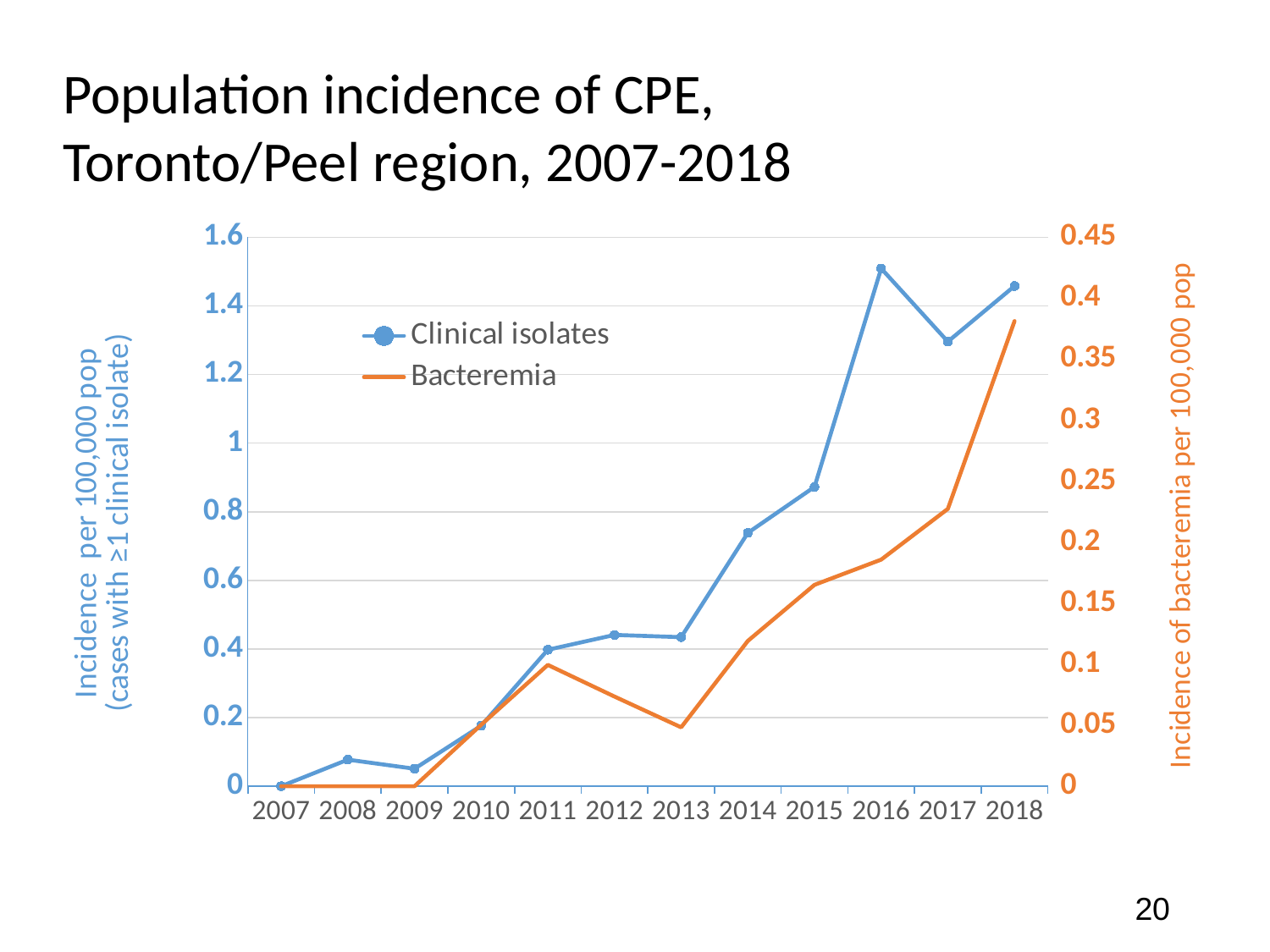
Is the Clinical isolates value for 2016 greater or less than 1.4? greater In which year is the Clinical isolates incidence highest? 2016 Is the Bacteremia value for 2018 greater or less than 0.35? greater What is the Clinical isolates incidence in 2007? 0 Is the Clinical isolates value for 2014 greater or less than 0.8? less Does the Clinical isolates incidence rise or fall from 2013 to 2016? rise In which year is the Bacteremia incidence highest? 2018 How many series does the legend list? 2 What is the Bacteremia incidence in 2009? 0 Which is larger, the Clinical isolates value for 2016 or for 2017? 2016 How many years are shown on the x axis? 12 What kind of chart is shown on the slide? line chart